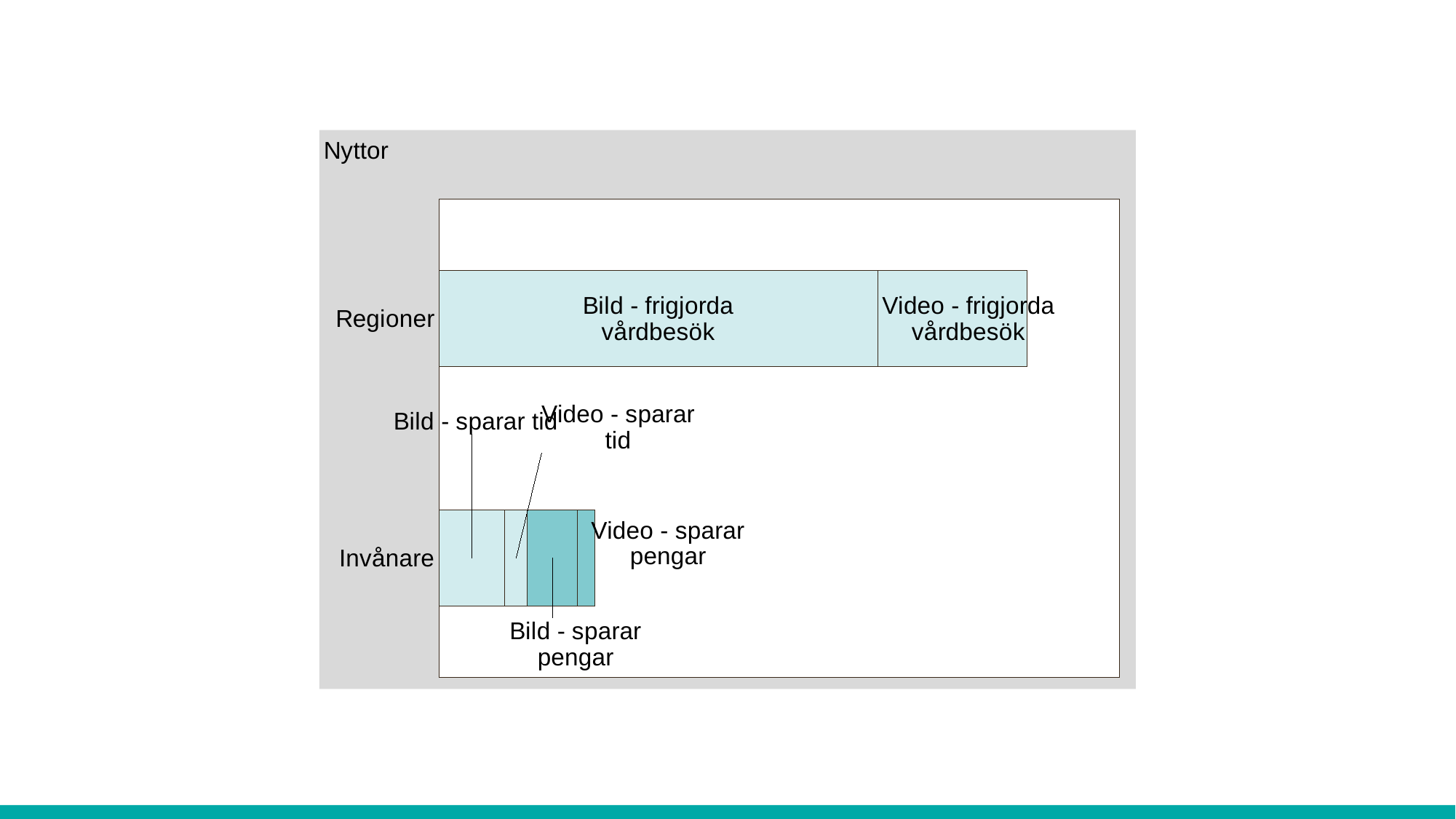
How many segments make up the Regioner bar? 2 In the Regioner bar, which segment is larger: 'Bild - frigjorda vårdbesök' or 'Video - frigjorda vårdbesök'? Bild - frigjorda vårdbesök What is the title of the chart? Nyttor In the Invånare bar, which segment is larger: 'Bild - sparar tid' or 'Video - sparar tid'? Bild - sparar tid Which category has the longest total bar? Regioner How many segments make up the Invånare bar? 4 What are the two segments of the Regioner bar labelled? Bild - frigjorda vårdbesök; Video - frigjorda vårdbesök How many categories are shown on the chart's vertical axis? 2 Which category has the shortest total bar? Invånare Which category has the longer total bar, Regioner or Invånare? Regioner What kind of chart is shown on the slide? Stacked bar chart